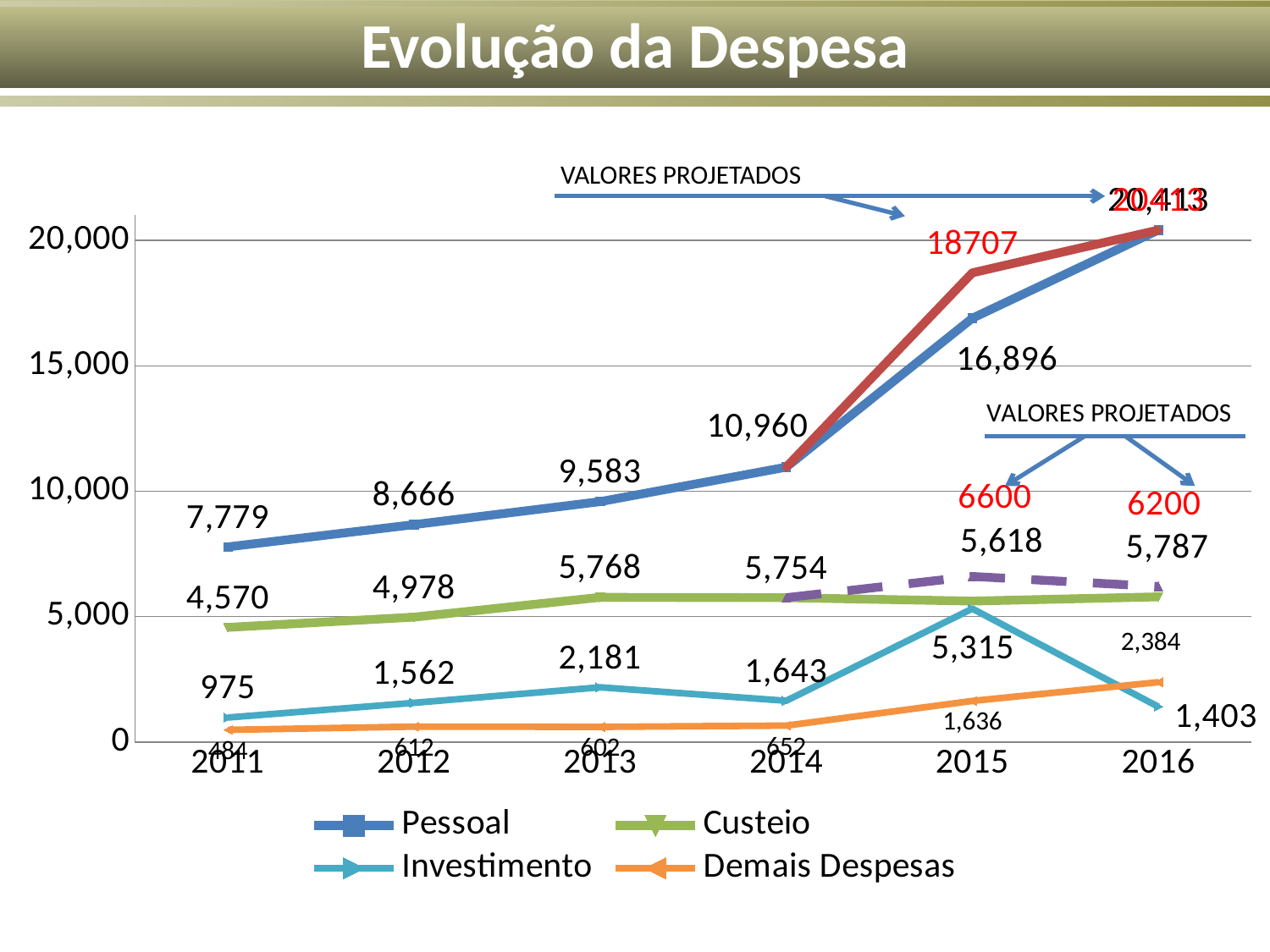
What is the value for Investimento in 2015? 5,315 Which is larger in 2014, the Custeio value or the Investimento value? Custeio What is the value for Custeio in 2013? 5,768 What is the difference between the Pessoal values in 2015 and 2014? 5,936 What is the value for Demais Despesas in 2016? 2,384 What is the value for Pessoal in 2011? 7,779 In which year is the Investimento value highest? 2015 What kind of chart is shown on the slide? Line chart What is the value for Pessoal in 2015? 16,896 How many series does the legend list? 4 Does the Pessoal series rise or fall from 2011 to 2016? Rise In which year is the Pessoal value lowest? 2011